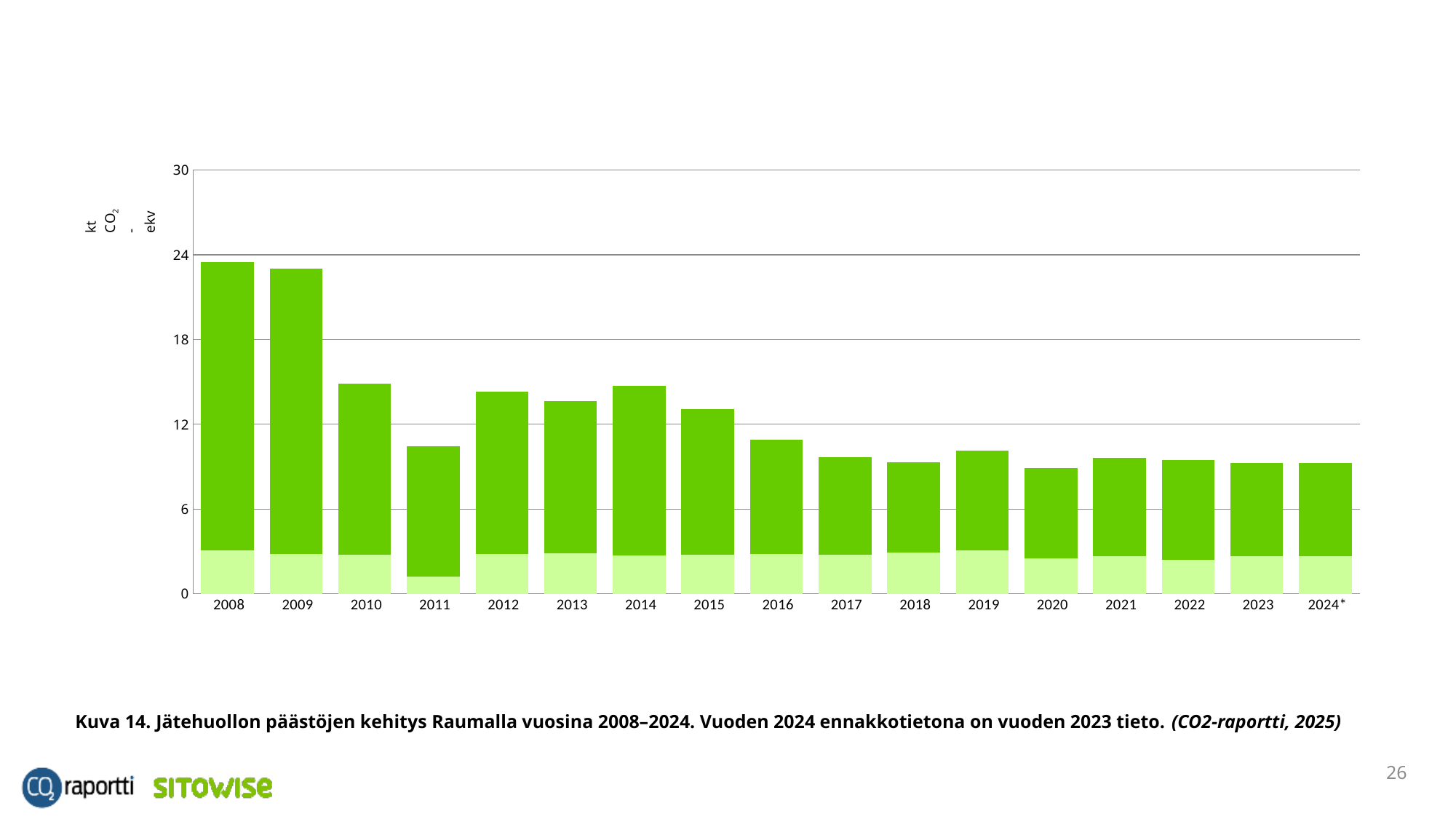
Which year has the highest total bar in the chart? 2008 What unit is shown on the y axis of the chart? kt CO2-ekv Which year has the larger total bar, 2014 or 2016? 2014 How many years are shown on the x axis of the chart? 17 Do the total values generally rise or fall from 2008 to 2024? fall Is the total value for 2008 greater or less than 18? greater What kind of chart is shown on the slide? bar chart Is the total value for 2016 greater or less than 12? less Which year has the larger total bar, 2010 or 2011? 2010 Is the total value for 2020 greater or less than 6? greater